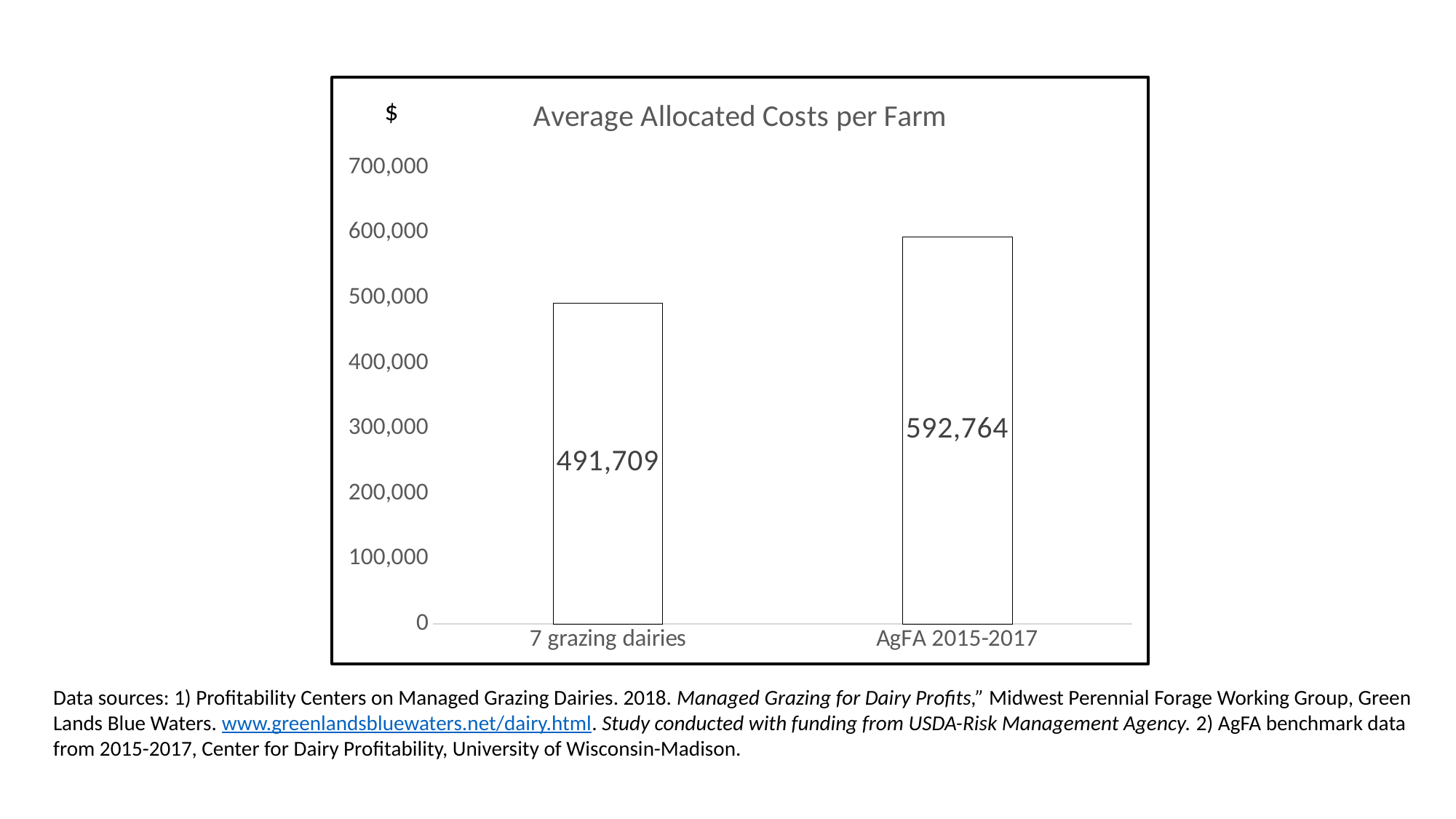
How many categories are shown on the chart? 2 Is the value for 7 grazing dairies larger or smaller than the value for AgFA 2015-2017? smaller Is the value for AgFA 2015-2017 greater or less than 500,000? greater What kind of chart is shown on the slide? bar chart What is the highest value labelled on the vertical axis? 700,000 What is the average allocated cost per farm for AgFA 2015-2017? 592,764 Which category has the higher average allocated cost per farm? AgFA 2015-2017 Is the value for 7 grazing dairies greater or less than 500,000? less Which category has the lower average allocated cost per farm? 7 grazing dairies What is the title of the chart? Average Allocated Costs per Farm What is the average allocated cost per farm for the 7 grazing dairies? 491,709 What is the difference between the AgFA 2015-2017 value and the 7 grazing dairies value? 101,055